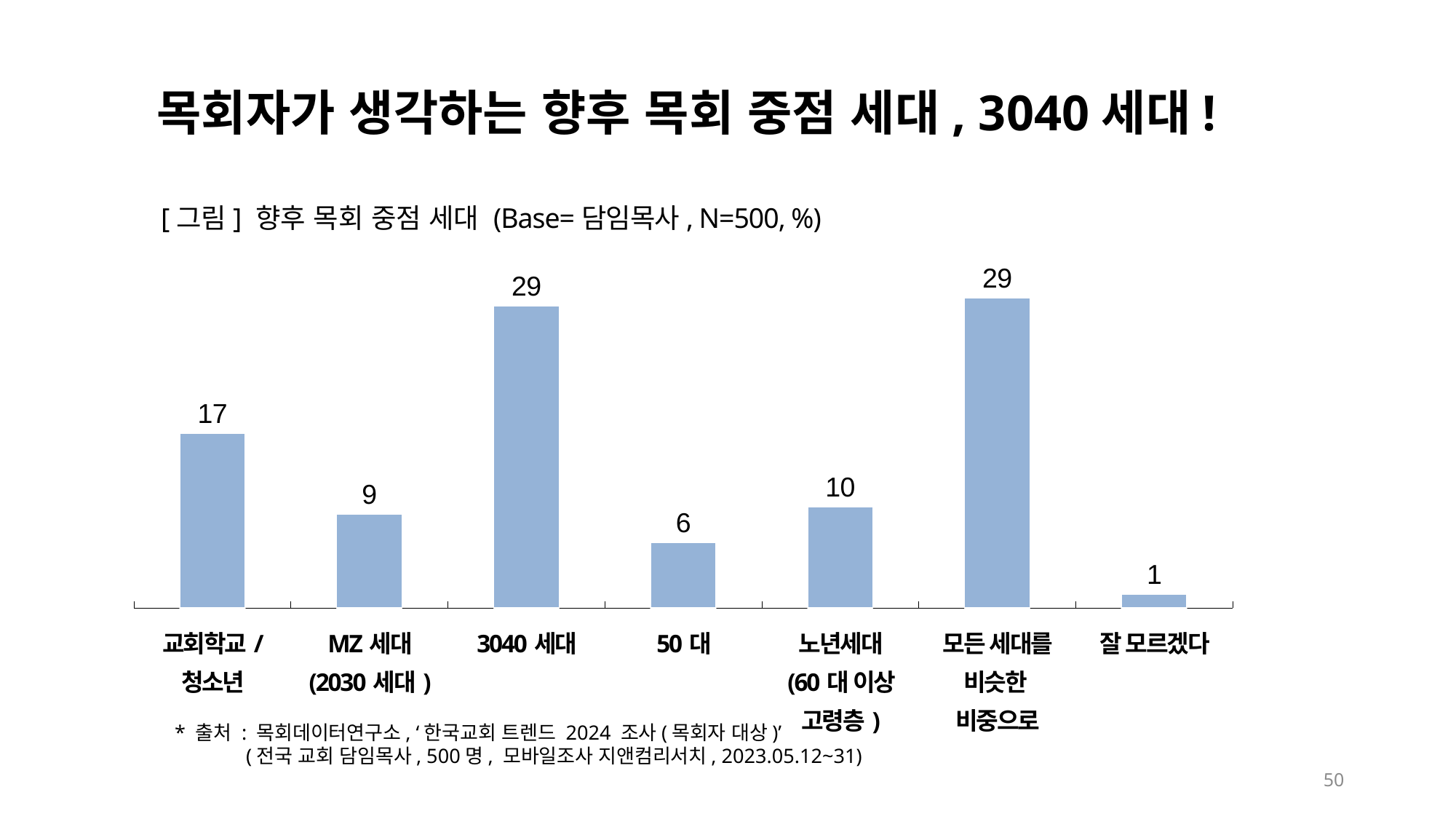
What is the difference between the values for 3040 세대 and 교회학교 / 청소년? 12 Which is larger, the value for 교회학교 / 청소년 or the value for MZ 세대 (2030 세대)? 교회학교 / 청소년 Which category has the lowest value? 잘 모르겠다 What is the value for 교회학교 / 청소년? 17 How many categories are shown in the chart? 7 What is the base (N) stated in the chart caption? N=500 What is the difference between the values for 노년세대 (60대 이상 고령층) and 50대? 4 What is the value for 노년세대 (60대 이상 고령층)? 10 What is the value for 50대? 6 What kind of chart is shown on the slide? Bar chart What is the value for 3040 세대? 29 What is the value for MZ 세대 (2030 세대)? 9